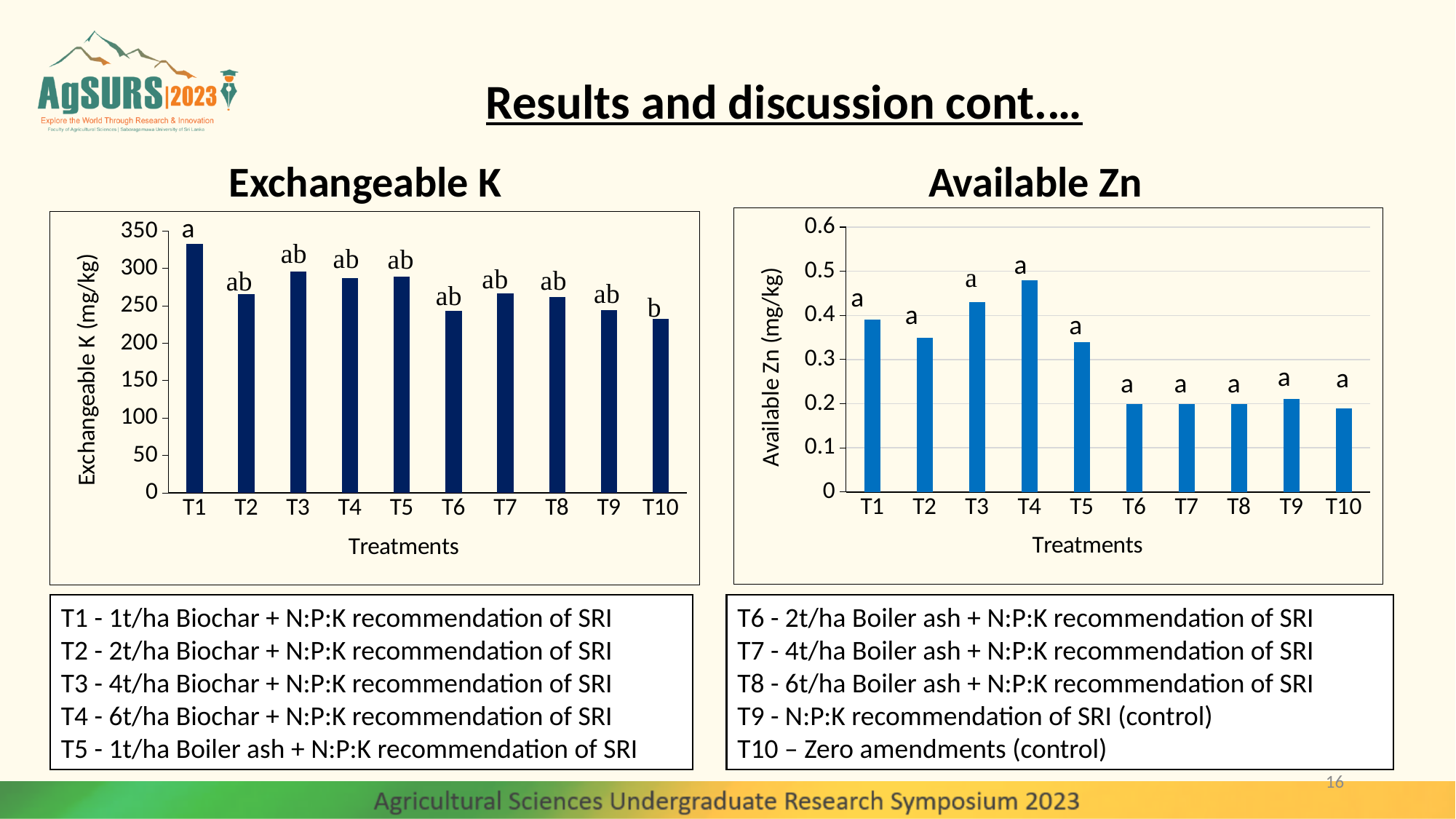
In the Exchangeable K chart, which treatment has the highest exchangeable K? T1 In the Available Zn chart, which treatment has the highest available Zn? T4 In the Exchangeable K chart, which is larger, the value for T1 or the value for T2? T1 In the Available Zn chart, is the value for T6 greater or less than 0.3? less In the Exchangeable K chart, is the value for T10 greater or less than 250? less In the Exchangeable K chart, which treatment has the lowest exchangeable K? T10 In the Available Zn chart, is the value for T4 greater or less than 0.4? greater What kind of chart is the Exchangeable K chart? Bar chart How many treatments are shown on the x axis of the Available Zn chart? 10 In the Available Zn chart, which is larger, the value for T3 or the value for T5? T3